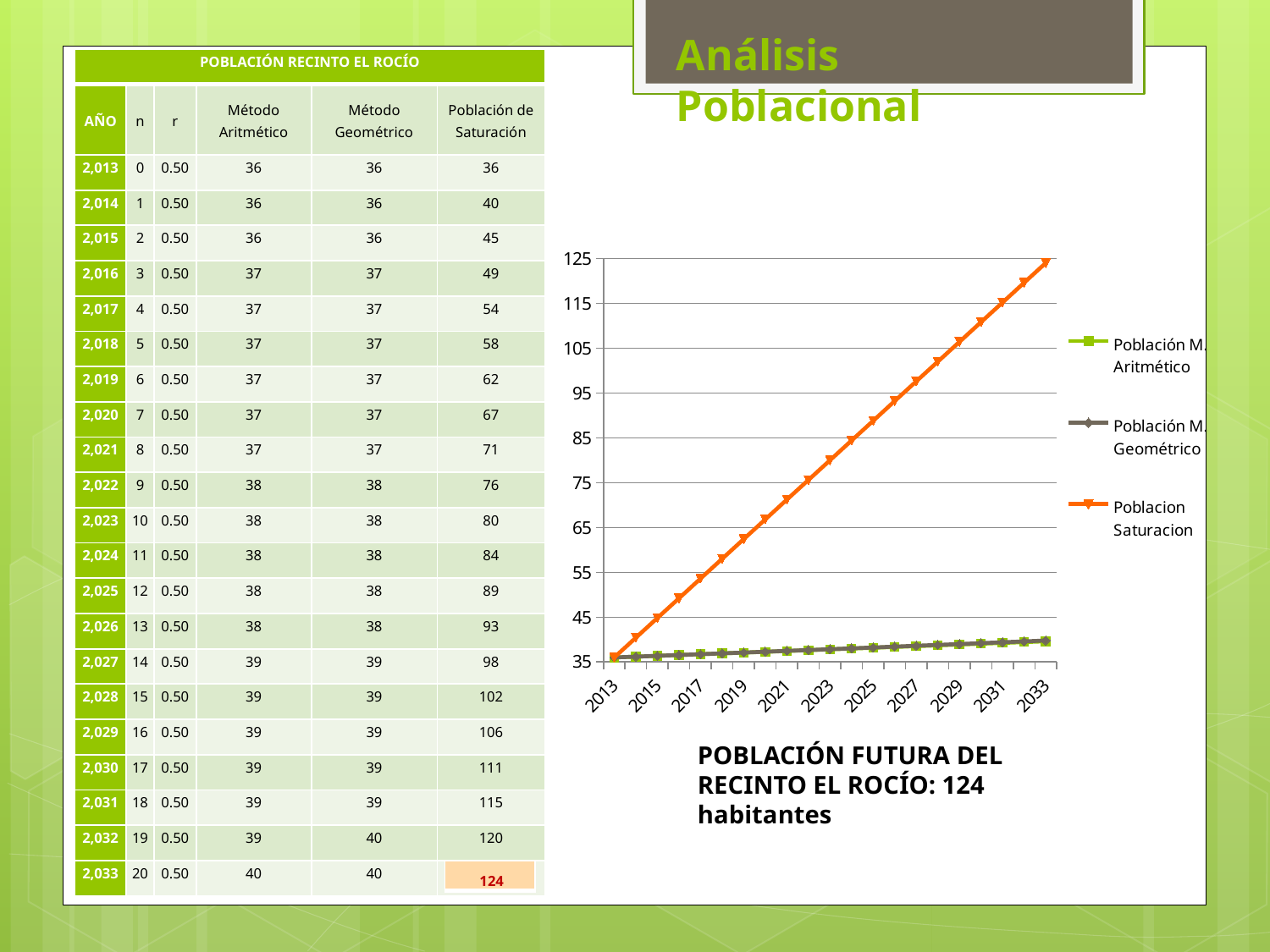
What kind of chart is shown on the slide? line chart Is the value of Población M. Aritmético in 2033 greater or less than 45? less How many year labels are shown on the x axis of the chart? 11 What colour is the Poblacion Saturacion line in the chart? orange What is the first year shown on the x axis of the chart? 2013 Is the value of Poblacion Saturacion in 2017 greater or less than 45? greater In 2033, which is larger: Poblacion Saturacion or Población M. Geométrico? Poblacion Saturacion Does the Poblacion Saturacion series rise or fall from 2013 to 2033? rise How many series does the chart legend list? 3 Which series in the chart reaches the highest value by 2033? Poblacion Saturacion Is the value of Poblacion Saturacion in 2029 greater or less than 95? greater